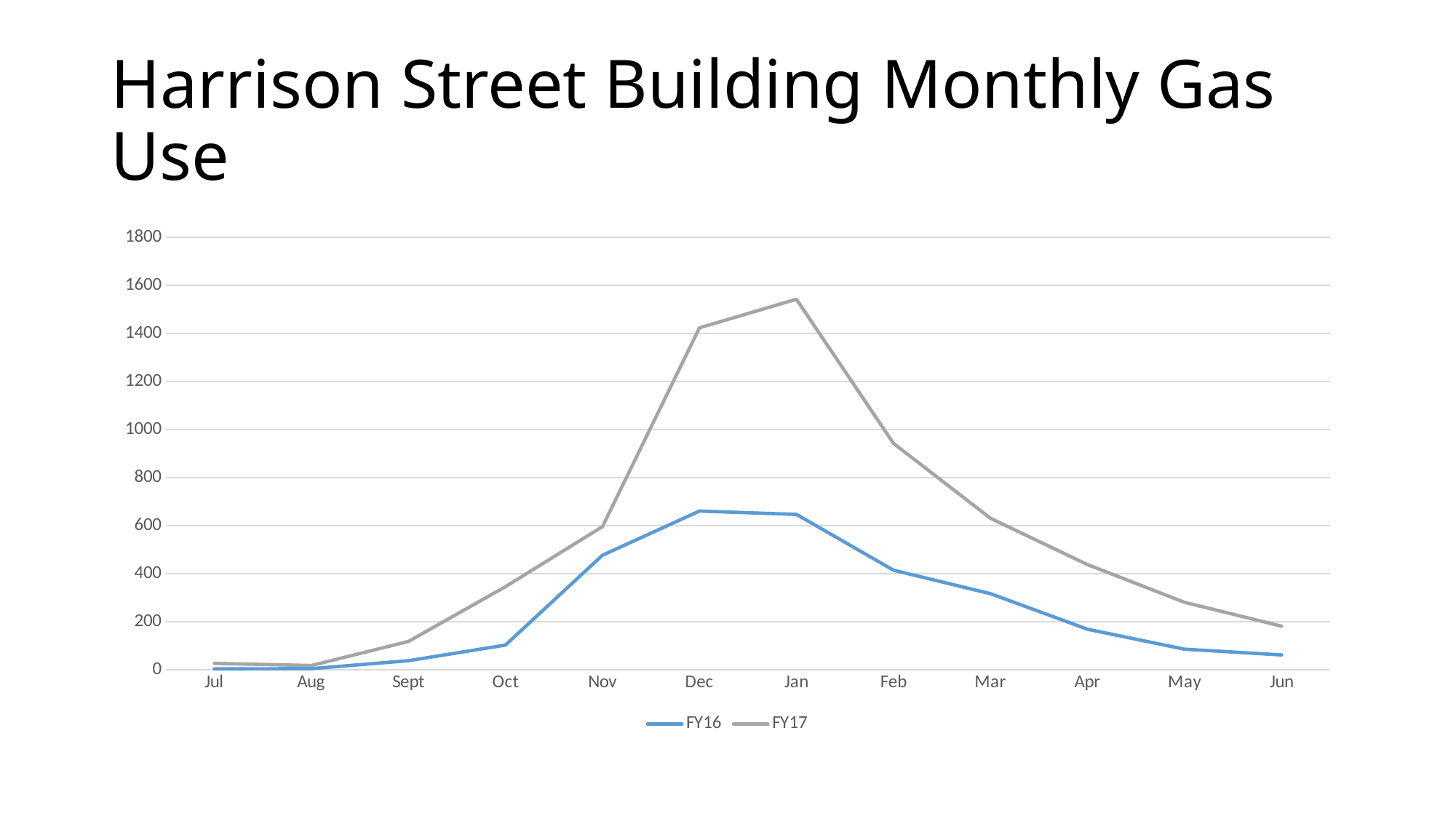
Do the FY17 values rise or fall from Jan to Jun? fall Which series has the larger value in Jan, FY16 or FY17? FY17 Which month has the highest FY17 value? Jan What is the title of the chart on the slide? Harrison Street Building Monthly Gas Use What kind of chart is shown on the slide? line chart Is the FY16 value for Dec greater or less than 800? less Which month has the highest FY16 value? Dec Is the FY17 value for Feb greater or less than 800? greater How many series does the legend list? 2 Is the FY16 value for Oct greater or less than 200? less How many months are plotted along the x axis? 12